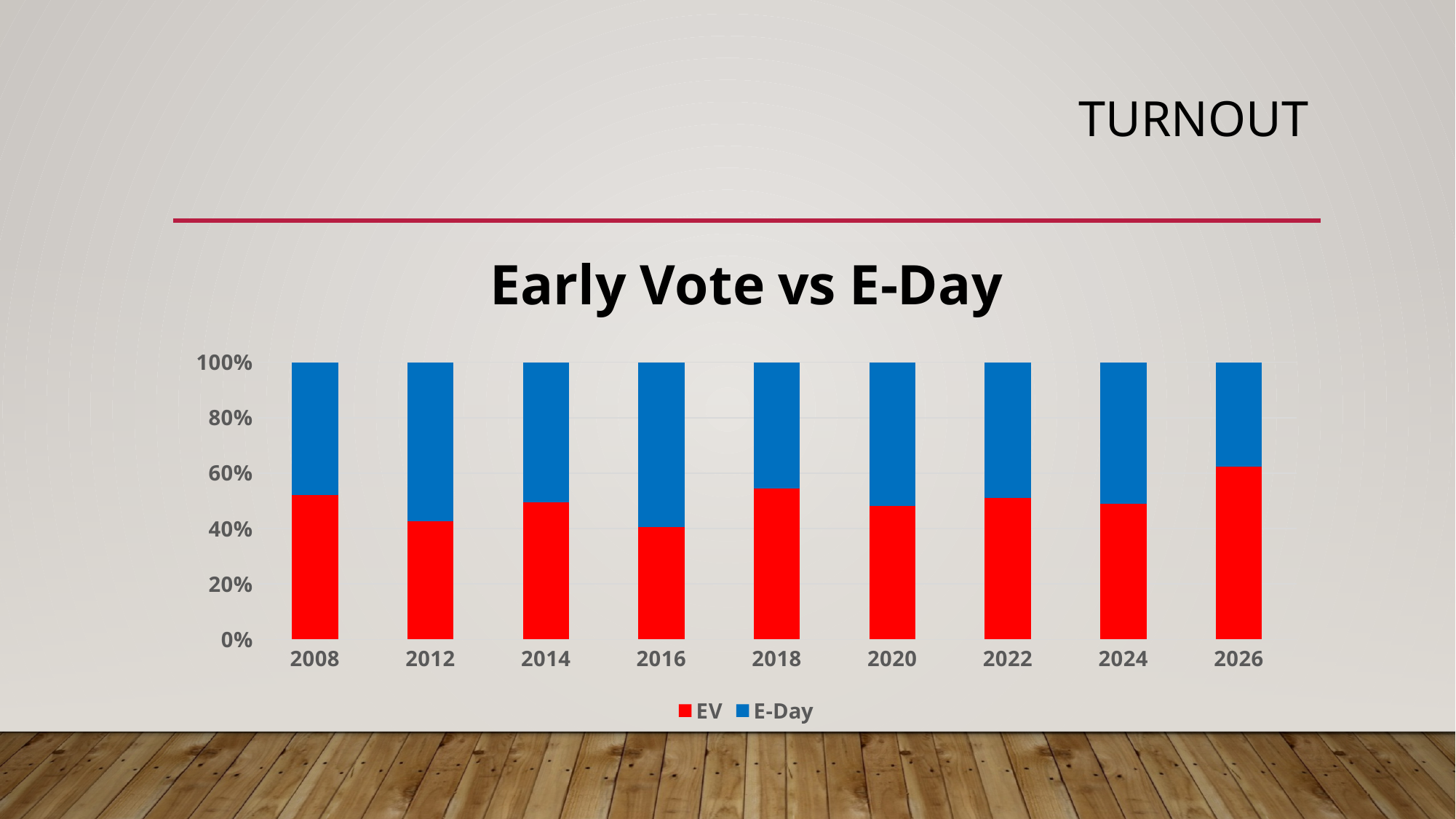
What kind of chart is shown on the slide? Stacked bar chart Is the EV value for 2026 greater or less than 40%? greater Which year has a larger EV share, 2018 or 2016? 2018 Is the EV value for 2012 greater or less than 60%? less What is the total of the stacked bar for 2020? 100% In which year is the EV share the highest? 2026 Which series is shown in red in the chart? EV Is the EV value for 2016 greater or less than 20%? greater How many series does the legend list? 2 What is the title of the chart? Early Vote vs E-Day Which year has a larger EV share, 2026 or 2012? 2026 How many years are shown on the x axis of the chart? 9